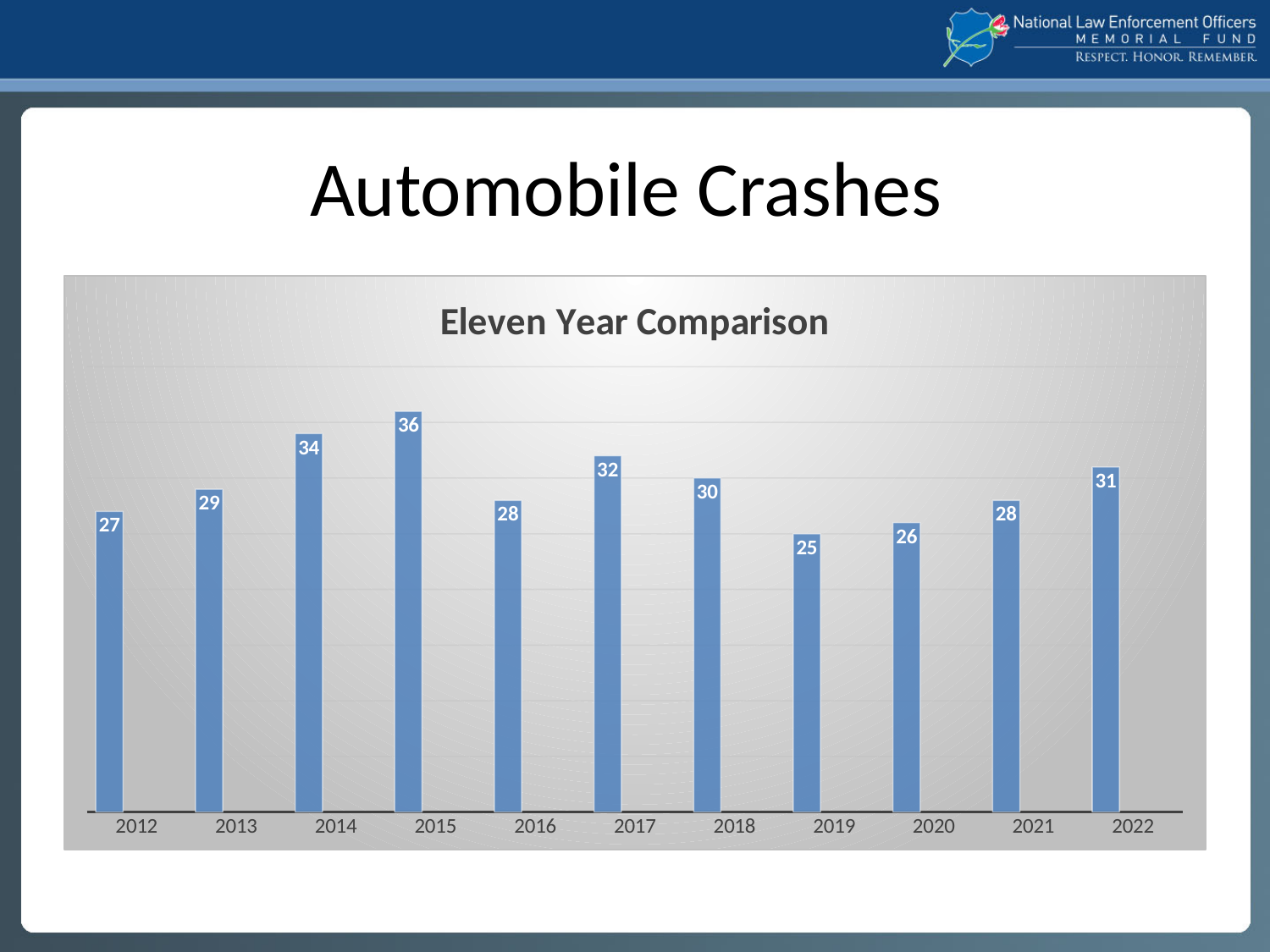
Do the values rise or fall from 2019 to 2022? Rise What kind of chart is this? Bar chart How many years are shown on the x axis? 11 Which year has the highest value? 2015 Which year has the lowest value? 2019 What is the value for 2022? 31 What is the difference between the values for 2014 and 2013? 5 What is the value for 2015? 36 Which is larger, the value for 2017 or the value for 2018? 2017 What is the difference between the values for 2015 and 2019? 11 What is the value for 2019? 25 What is the title of the chart? Eleven Year Comparison